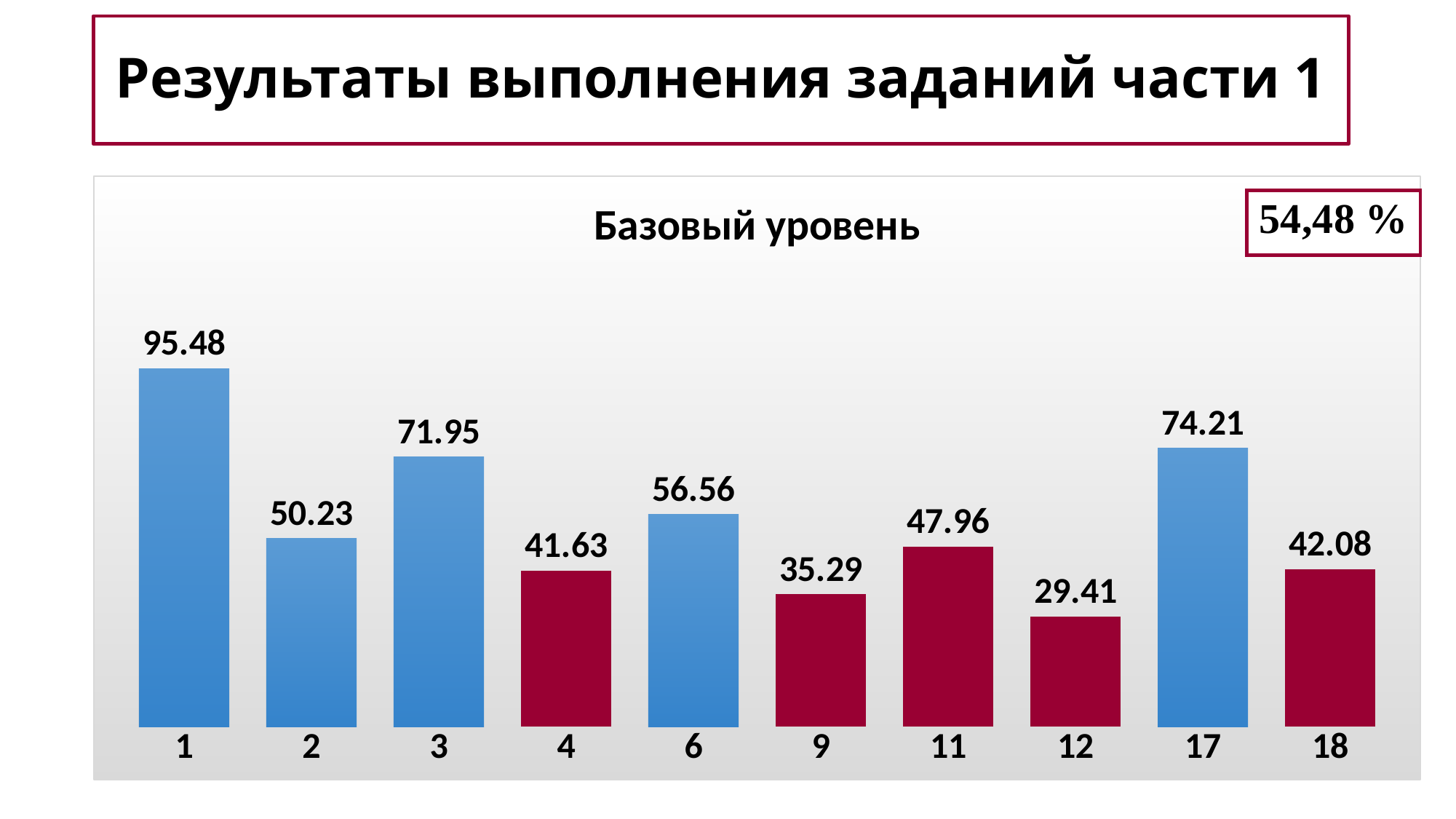
What is the value for category 12? 29.41 What percentage is shown in the box at the top right of the chart? 54,48 % How many categories are shown on the x axis? 10 What is the title of the chart? Базовый уровень What is the value for category 17? 74.21 Which is larger, the value for category 6 or the value for category 11? 6 Which category has the highest value? 1 What is the difference between the values for category 17 and category 18? 32.13 What kind of chart is shown? bar chart What is the difference between the values for category 1 and category 3? 23.53 What is the value for category 1? 95.48 Which category has the lowest value? 12